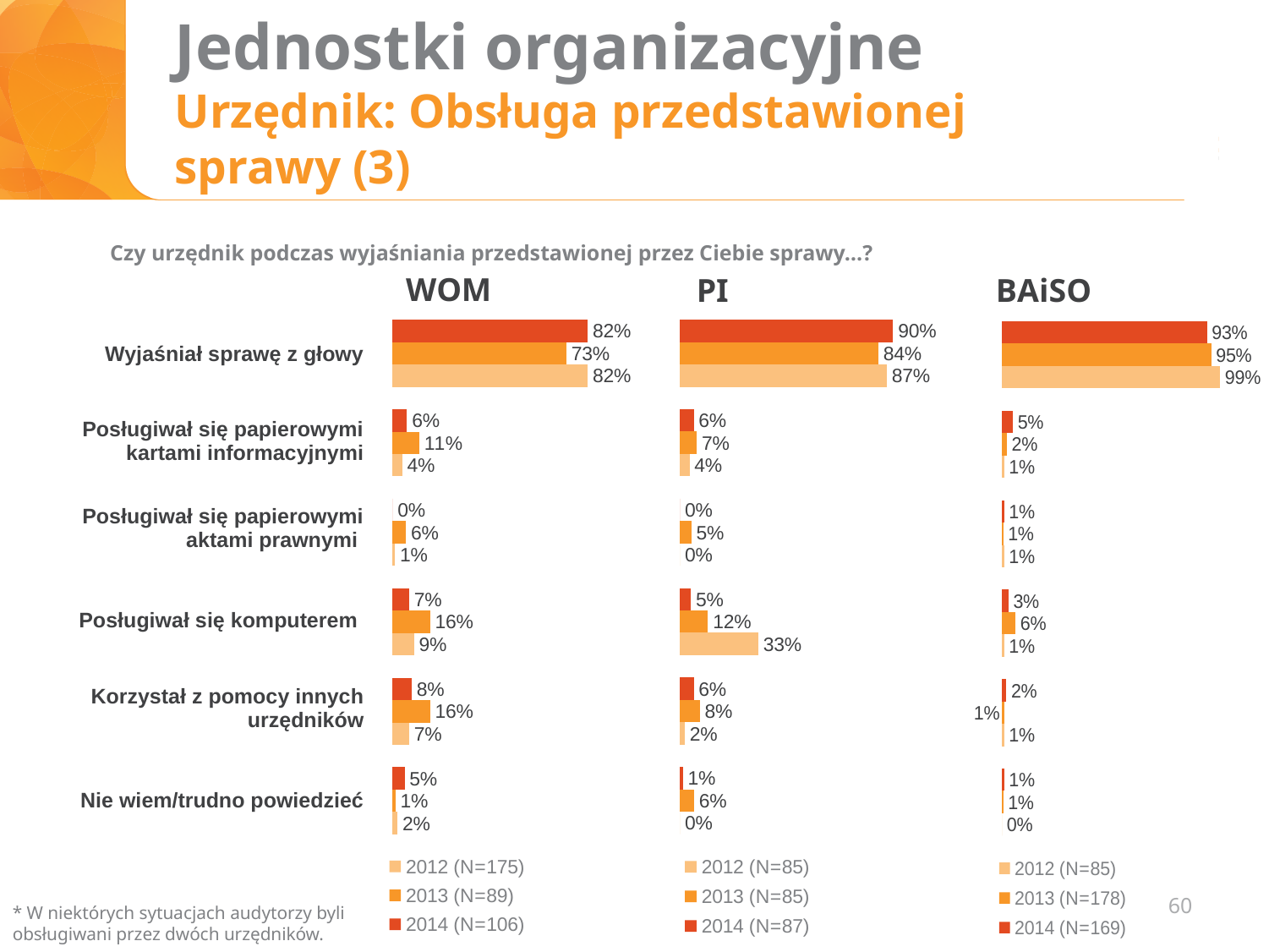
In the WOM chart, what is the difference between the 2014 and 2013 values for "Wyjaśniał sprawę z głowy"? 9 percentage points What kind of chart is the PI chart? Bar chart In the PI chart, which is larger for "Posługiwał się komputerem": the 2013 value or the 2012 value? 2012 In the PI chart, what is the 2013 value for "Posługiwał się papierowymi aktami prawnymi"? 5% In the BAiSO chart, what is the sample size (N) for 2013 shown in the legend? 178 How many categories are shown in the WOM chart? 6 In the BAiSO chart, what is the 2012 value for "Wyjaśniał sprawę z głowy"? 99% In the PI chart, what is the 2012 value for "Posługiwał się komputerem"? 33% In the WOM chart, what is the 2013 value for "Korzystał z pomocy innych urzędników"? 16% In the PI chart, which category has the highest 2014 value? Wyjaśniał sprawę z głowy In the WOM chart, what is the 2014 value for "Wyjaśniał sprawę z głowy"? 82% How many series does the legend of the BAiSO chart list? 3